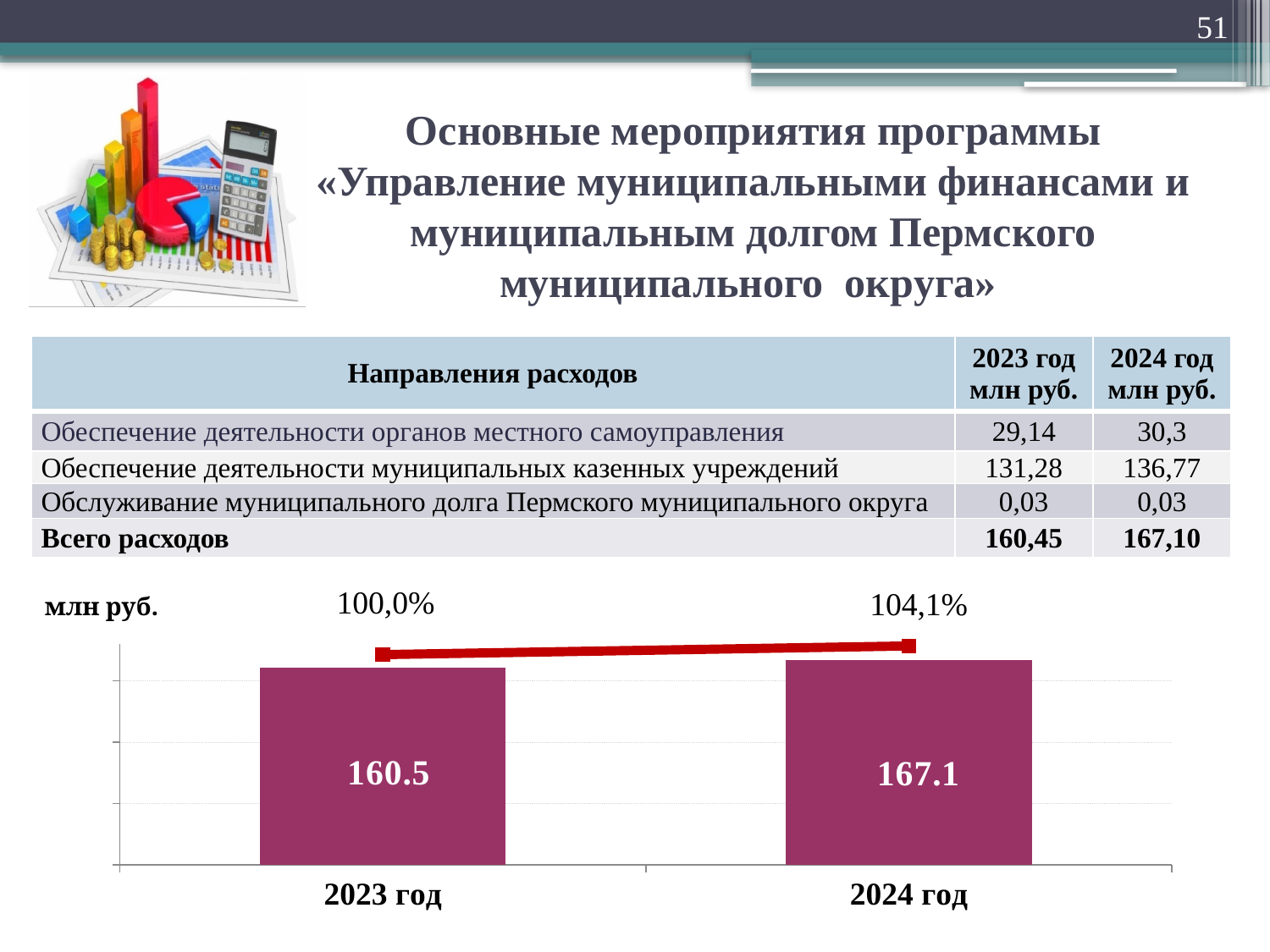
What is the value for 2023 год in the bar chart? 160.5 Do the bar values rise or fall from 2023 год to 2024 год? rise What is the difference between the 2024 год and 2023 год bar values? 6.6 How many bars are shown in the chart? 2 What percentage label is shown above the 2024 год bar on the line? 104,1% What is the value for 2024 год in the bar chart? 167.1 What percentage label is shown above the 2023 год bar on the line? 100,0% Which year has the lower bar in the chart? 2023 год What kind of chart is shown at the bottom of the slide? bar chart Which year has the higher bar in the chart? 2024 год Is the bar for 2024 год larger or smaller than the bar for 2023 год? larger What unit is indicated at the top left of the chart? млн руб.